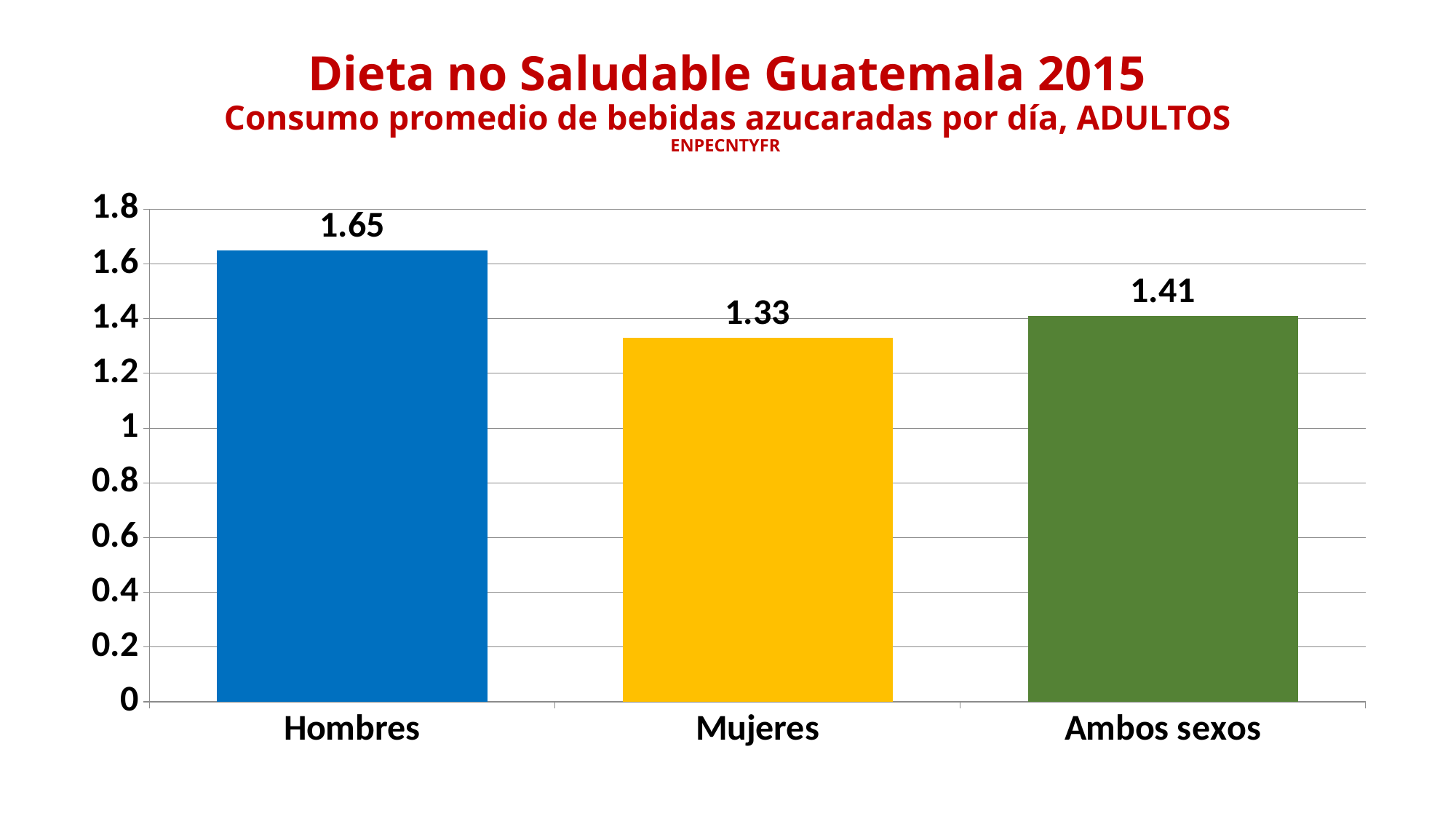
Which category has the highest value? Hombres What is the difference between the values for Ambos sexos and Mujeres? 0.08 What is the difference between the values for Hombres and Mujeres? 0.32 Which category has the lowest value? Mujeres What is the value for Mujeres? 1.33 What colour is the bar for Mujeres? yellow What is the value for Hombres? 1.65 Is the value for Mujeres greater or less than 1.4? less Which is larger, the value for Hombres or the value for Ambos sexos? Hombres What kind of chart is shown on the slide? bar chart What is the value for Ambos sexos? 1.41 How many categories are shown on the x axis? 3